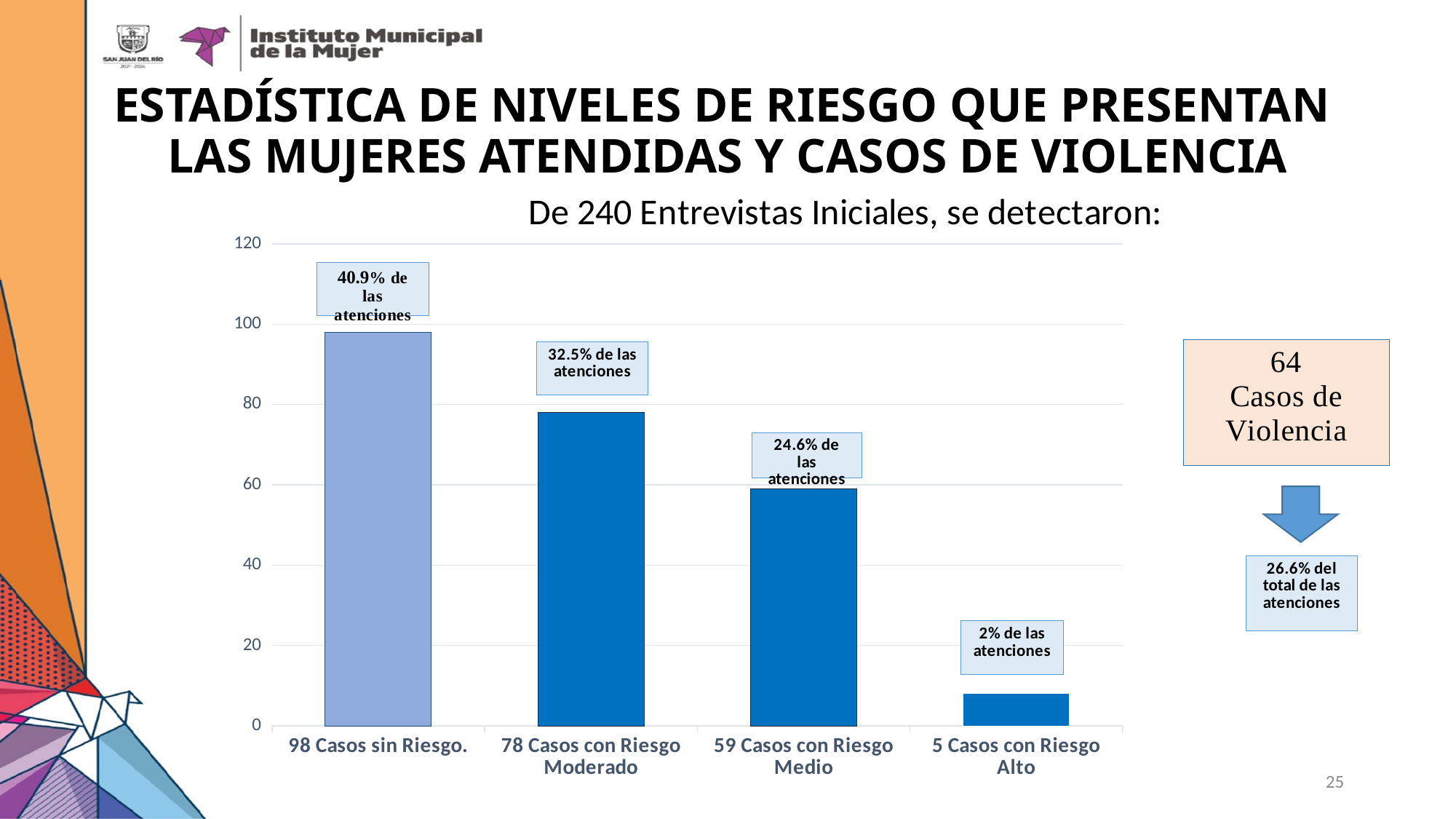
Which category has the highest bar in the chart? 98 Casos sin Riesgo. What is the title shown above the chart? De 240 Entrevistas Iniciales, se detectaron: What kind of chart is shown on the slide? bar chart How many cases are reported for 'Casos con Riesgo Moderado'? 78 Which is larger: the bar for 'Casos con Riesgo Moderado' or the bar for 'Casos con Riesgo Medio'? Casos con Riesgo Moderado What percentage of the atenciones is shown above the 'Casos sin Riesgo' bar? 40.9% de las atenciones Do the bar values rise or fall from left to right across the chart? fall What percentage of the atenciones is shown above the 'Casos con Riesgo Medio' bar? 24.6% de las atenciones How many categories (bars) does the chart show? 4 Which category has the lowest bar in the chart? 5 Casos con Riesgo Alto Is the value for 'Casos con Riesgo Alto' greater or less than 20? less What is the difference between the number of 'Casos sin Riesgo' and 'Casos con Riesgo Moderado'? 20